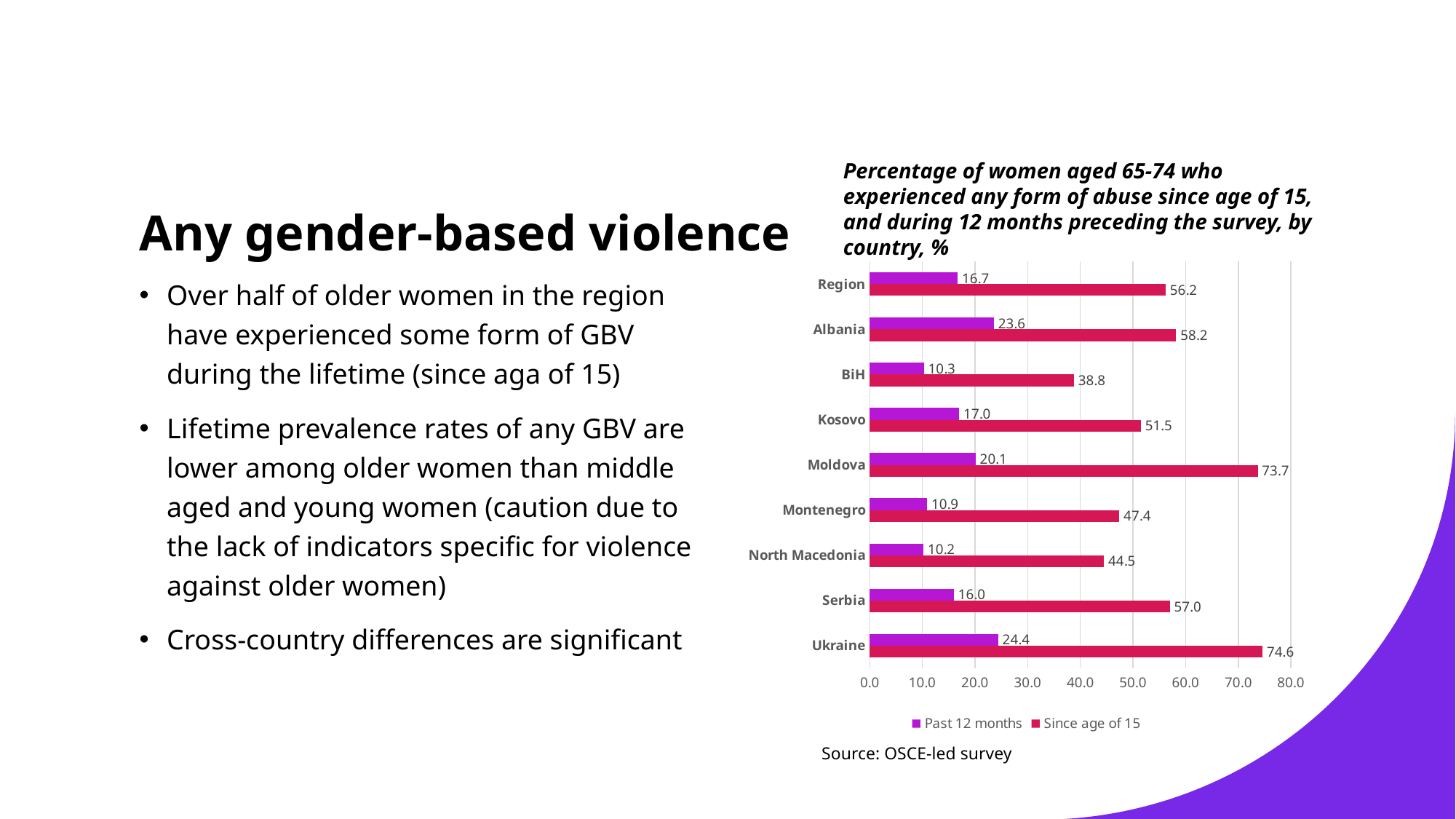
Which category has the lowest 'Past 12 months' value? North Macedonia What kind of chart is shown on the slide? bar chart What is the 'Past 12 months' value for Albania? 23.6 What is the 'Past 12 months' value for the Region? 16.7 How many series does the legend list? 2 What is the difference between the 'Since age of 15' and 'Past 12 months' values for Serbia? 41.0 Which country has the highest 'Since age of 15' value? Ukraine Which is larger: the 'Since age of 15' value for Kosovo or for Montenegro? Kosovo Is the 'Since age of 15' value for BiH greater or less than 40.0? less How many categories are shown on the y axis of the chart? 9 What is the 'Since age of 15' value for Moldova? 73.7 What is the source cited below the chart? OSCE-led survey